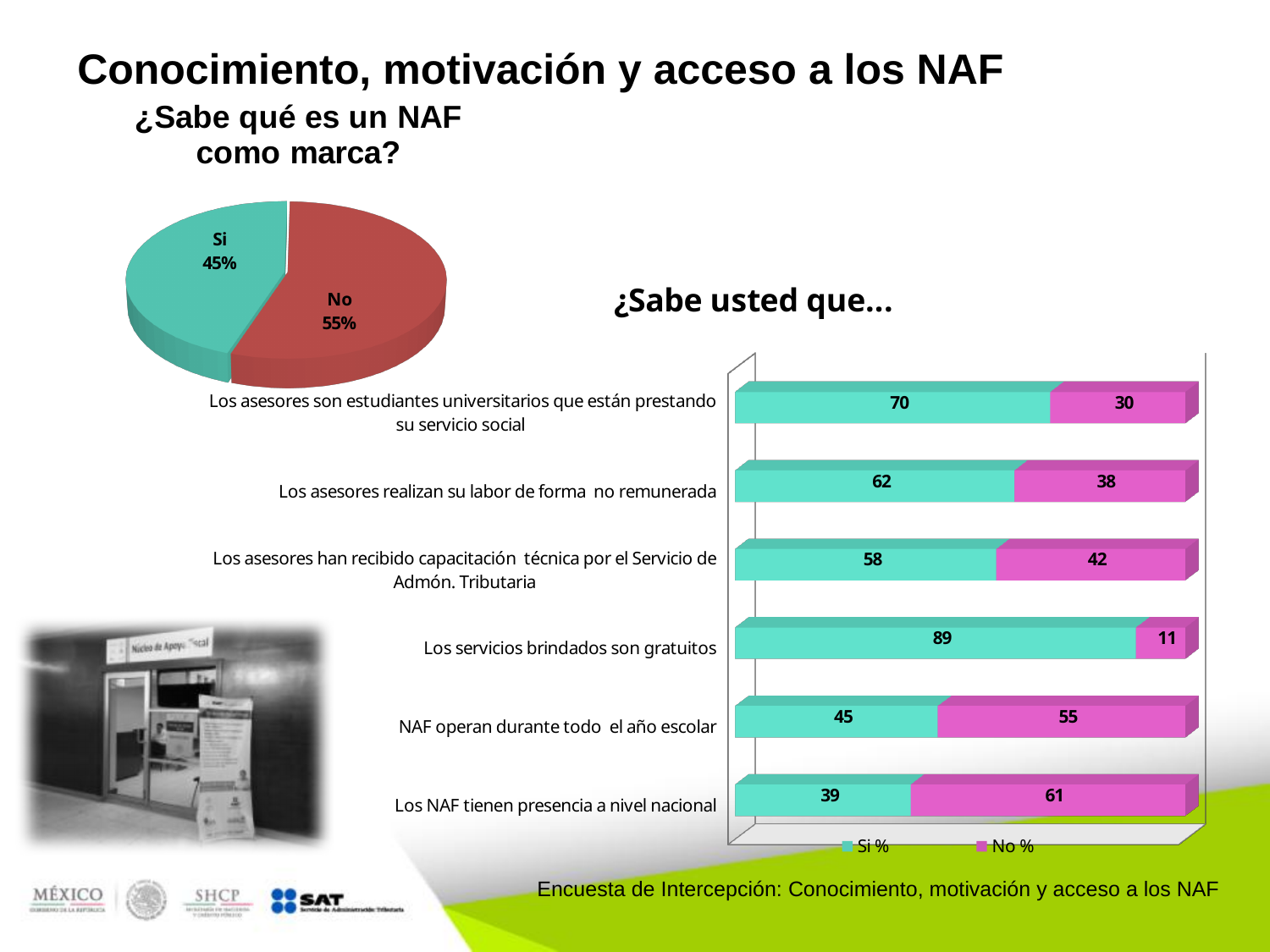
In the pie chart '¿Sabe qué es un NAF como marca?', what share of respondents answered 'No'? 55% In the '¿Sabe usted que...' chart, how many series does the legend list? 2 In the '¿Sabe usted que...' chart, which category has the lowest 'Si %' value? Los NAF tienen presencia a nivel nacional In the '¿Sabe usted que...' chart, what is the 'No %' value for 'Los NAF tienen presencia a nivel nacional'? 61 In the '¿Sabe usted que...' chart, which category has the highest 'Si %' value? Los servicios brindados son gratuitos In the '¿Sabe usted que...' chart, how many categories are shown? 6 In the pie chart '¿Sabe qué es un NAF como marca?', which slice is larger, 'Si' or 'No'? No What kind of chart is the '¿Sabe usted que...' chart? Stacked bar chart In the pie chart '¿Sabe qué es un NAF como marca?', what share of respondents answered 'Si'? 45% In the '¿Sabe usted que...' chart, what is the difference between the 'Si %' and 'No %' values for 'Los asesores realizan su labor de forma no remunerada'? 24 In the '¿Sabe usted que...' chart, what is the total of the stacked bar for 'NAF operan durante todo el año escolar'? 100 In the '¿Sabe usted que...' chart, what is the 'Si %' value for 'Los servicios brindados son gratuitos'? 89